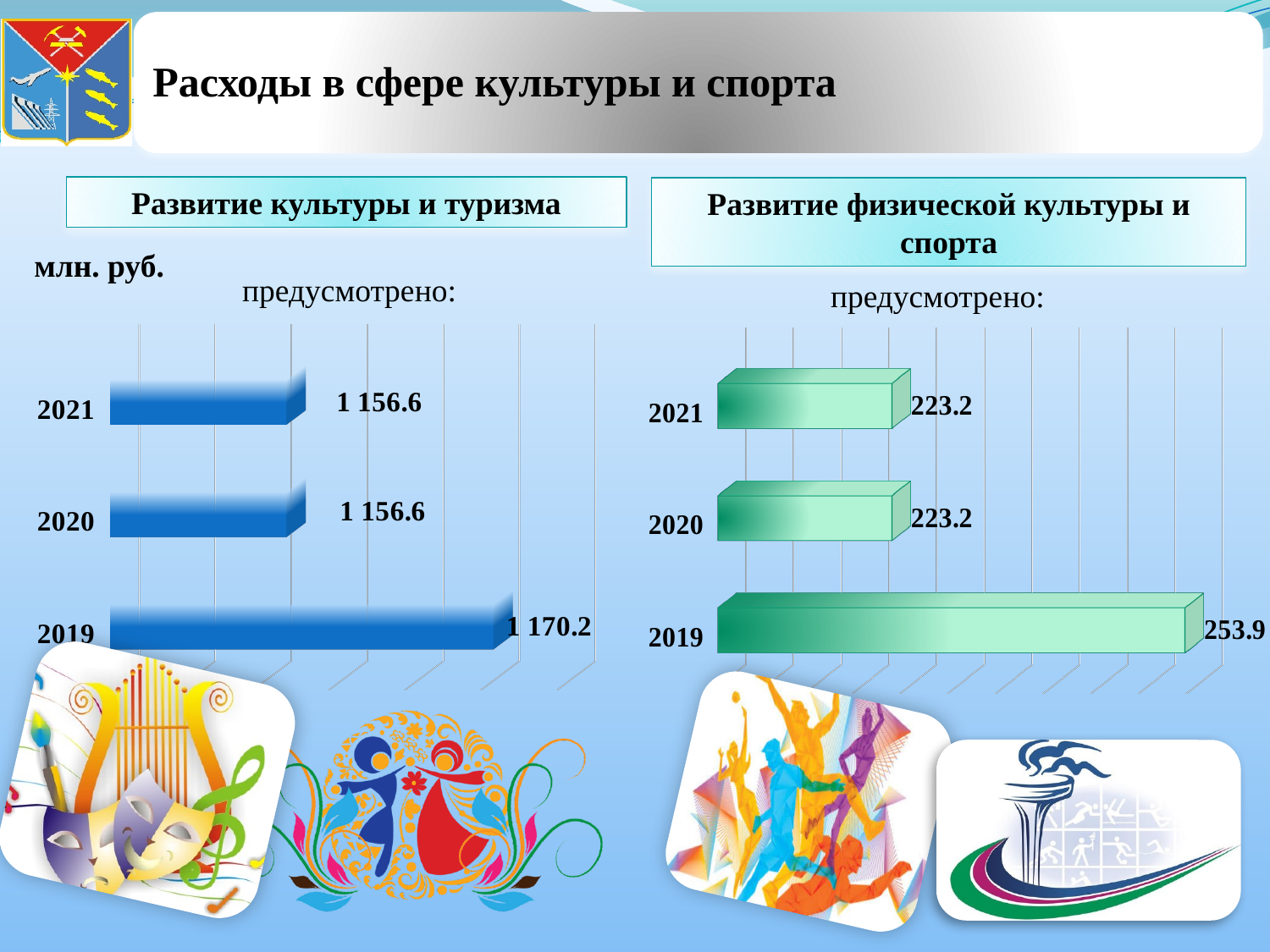
What unit is indicated for the values in the 'Развитие культуры и туризма' chart? млн. руб. How many years are shown in the 'Развитие культуры и туризма' chart? 3 What type of chart is used for 'Развитие физической культуры и спорта'? Bar chart In the 'Развитие физической культуры и спорта' chart, which is larger: the value for 2019 or the value for 2021? 2019 In the 'Развитие культуры и туризма' chart, which year has the highest value? 2019 In the 'Развитие культуры и туризма' chart, what is the difference between the values for 2019 and 2021? 13.6 In the 'Развитие физической культуры и спорта' chart, what is the difference between the values for 2019 and 2020? 30.7 In the 'Развитие физической культуры и спорта' chart, what is the value for 2020? 223.2 In the 'Развитие культуры и туризма' chart, what is the value for 2021? 1 156.6 In the 'Развитие физической культуры и спорта' chart, which year has the highest value? 2019 In the 'Развитие физической культуры и спорта' chart, what is the value for 2019? 253.9 In the 'Развитие культуры и туризма' chart, what is the value for 2019? 1 170.2